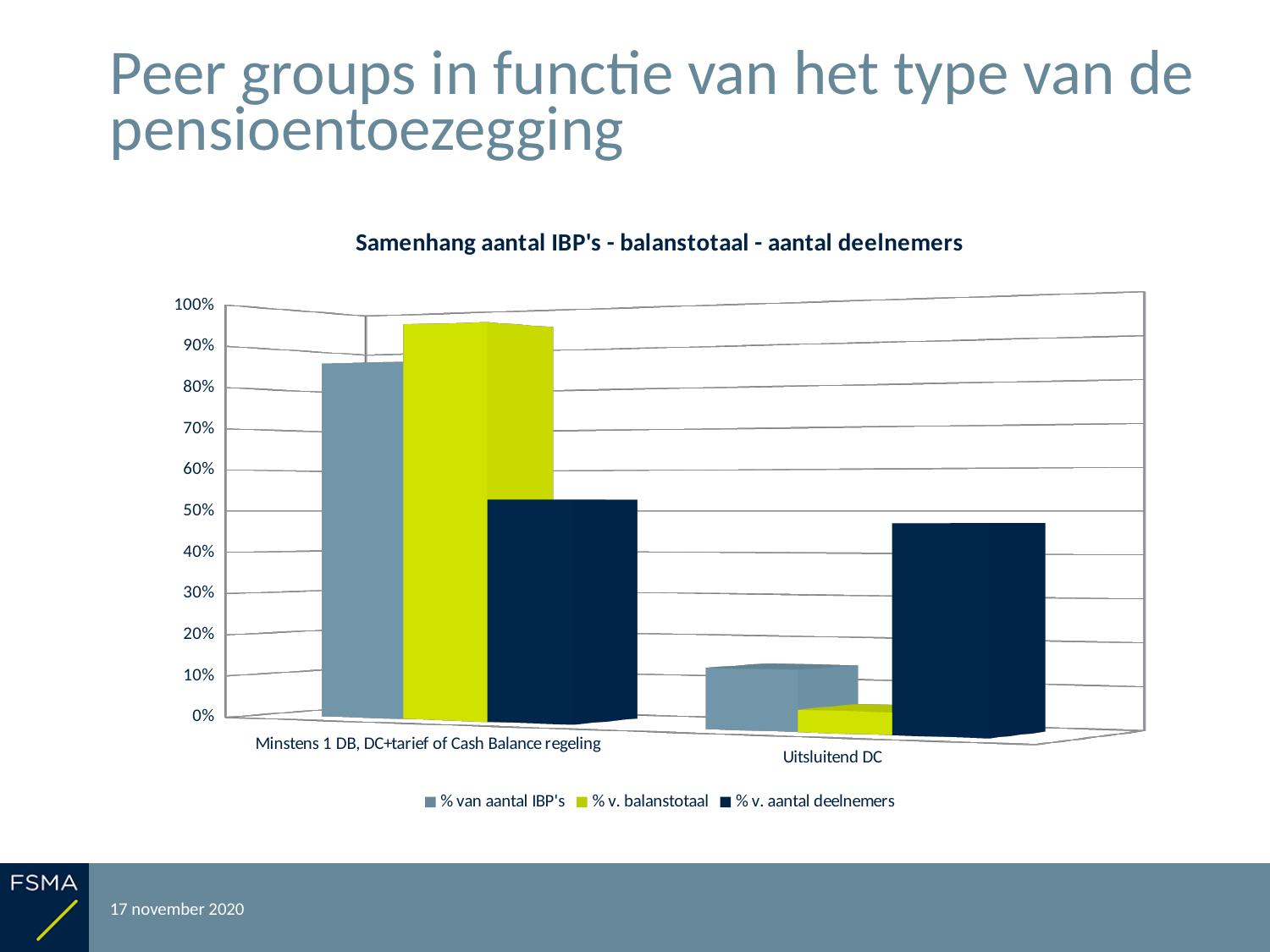
For the 'Uitsluitend DC' category, which is larger: '% v. aantal deelnemers' or '% van aantal IBP's'? % v. aantal deelnemers How many categories are shown on the x axis of the chart? 2 Which category has the lower value for '% van aantal IBP's'? Uitsluitend DC For the 'Minstens 1 DB, DC+tarief of Cash Balance regeling' category, which is larger: '% v. balanstotaal' or '% v. aantal deelnemers'? % v. balanstotaal Is the value for '% v. balanstotaal' in the 'Minstens 1 DB, DC+tarief of Cash Balance regeling' category greater or less than 80%? greater Is the value for '% van aantal IBP's' in the 'Uitsluitend DC' category greater or less than 30%? less How many series does the chart's legend list? 3 Which category has the higher value for '% v. balanstotaal'? Minstens 1 DB, DC+tarief of Cash Balance regeling What kind of chart is shown on the slide? bar chart Which series is shown in yellow-green in the chart? % v. balanstotaal Is the value for '% v. balanstotaal' in the 'Uitsluitend DC' category greater or less than 10%? less What is the title of the chart? Samenhang aantal IBP's - balanstotaal - aantal deelnemers